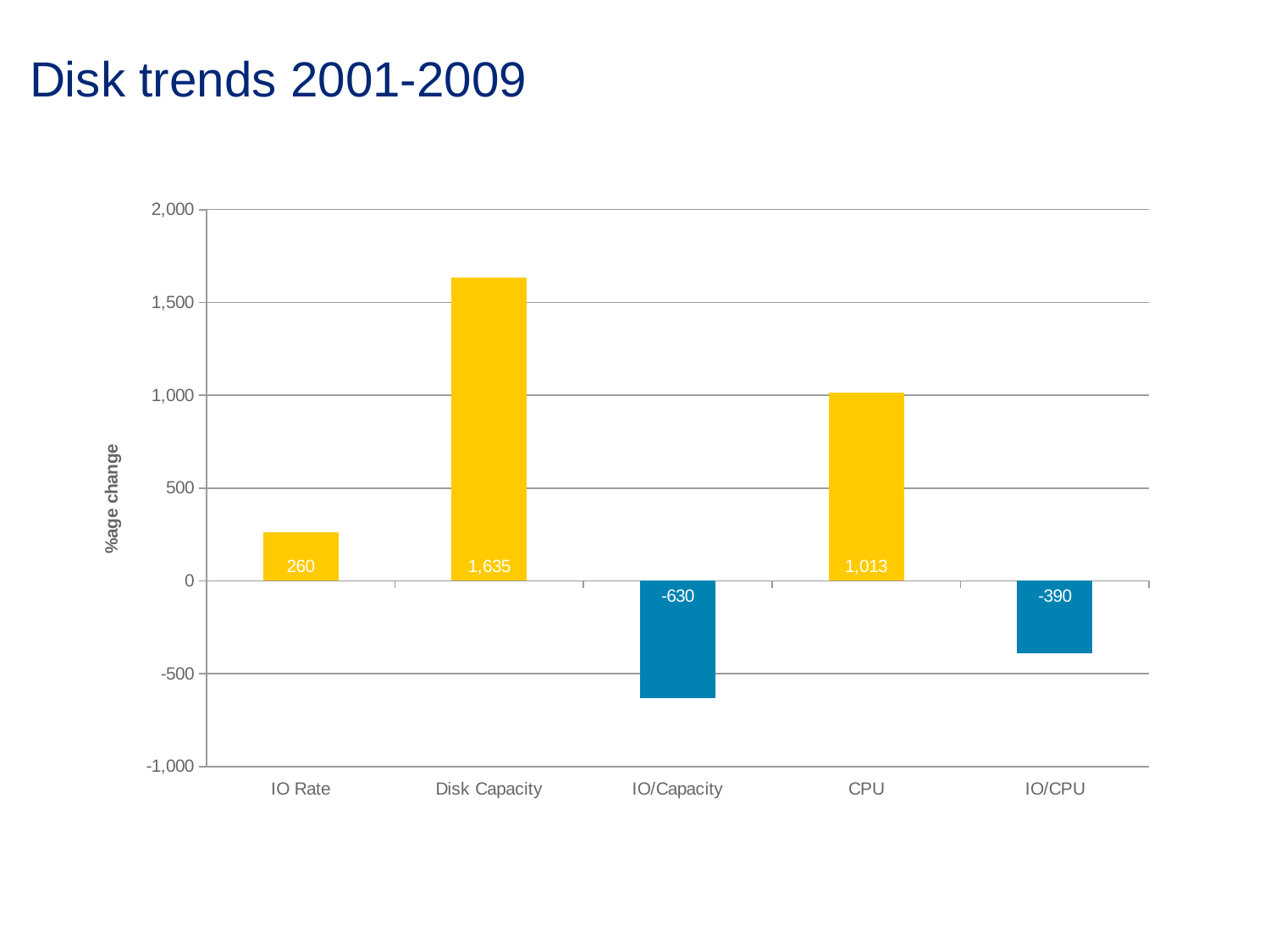
Which category has the lowest value? IO/Capacity What is the value for CPU? 1,013 Which category has the highest value? Disk Capacity What is the difference between the values for Disk Capacity and CPU? 622 What is the difference between the values for CPU and IO Rate? 753 How many categories are shown on the x axis? 5 What is the value for Disk Capacity? 1,635 What is the value for IO/Capacity? -630 What is the value for IO/CPU? -390 Which is larger, the value for IO Rate or the value for CPU? CPU Is the value for Disk Capacity greater or less than 1,500? greater What kind of chart is shown on the slide? bar chart